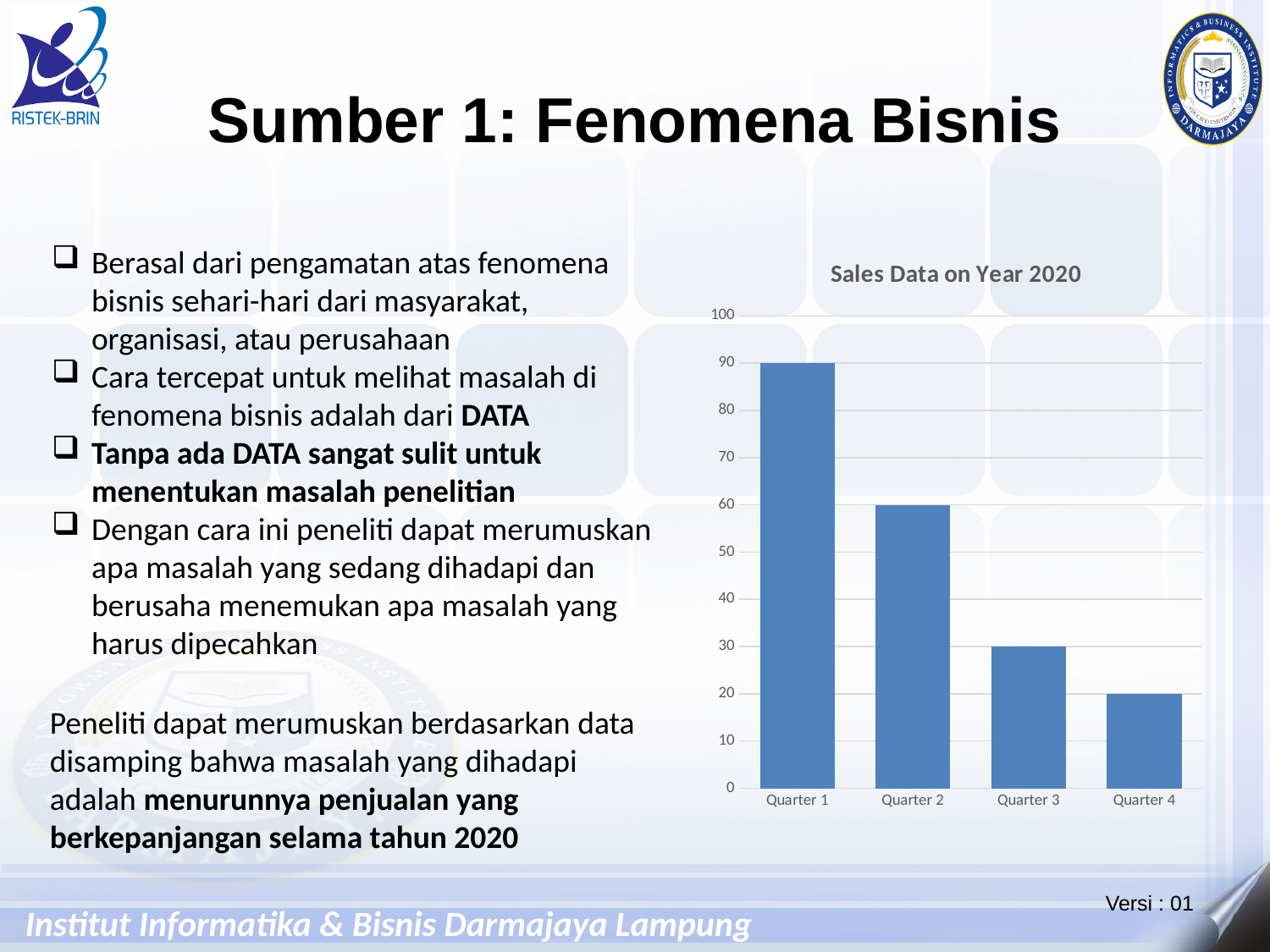
Do the values rise or fall from Quarter 1 to Quarter 4? fall How many quarters are plotted in the chart? 4 What is the difference between the values for Quarter 1 and Quarter 2? 30 What is the value for Quarter 1? 90 What is the value for Quarter 3? 30 Which is larger, the value for Quarter 2 or the value for Quarter 3? Quarter 2 Which quarter has the highest value? Quarter 1 Which quarter has the lowest value? Quarter 4 What is the title of the chart? Sales Data on Year 2020 What is the value for Quarter 4? 20 What is the value for Quarter 2? 60 What kind of chart is shown on the slide? bar chart